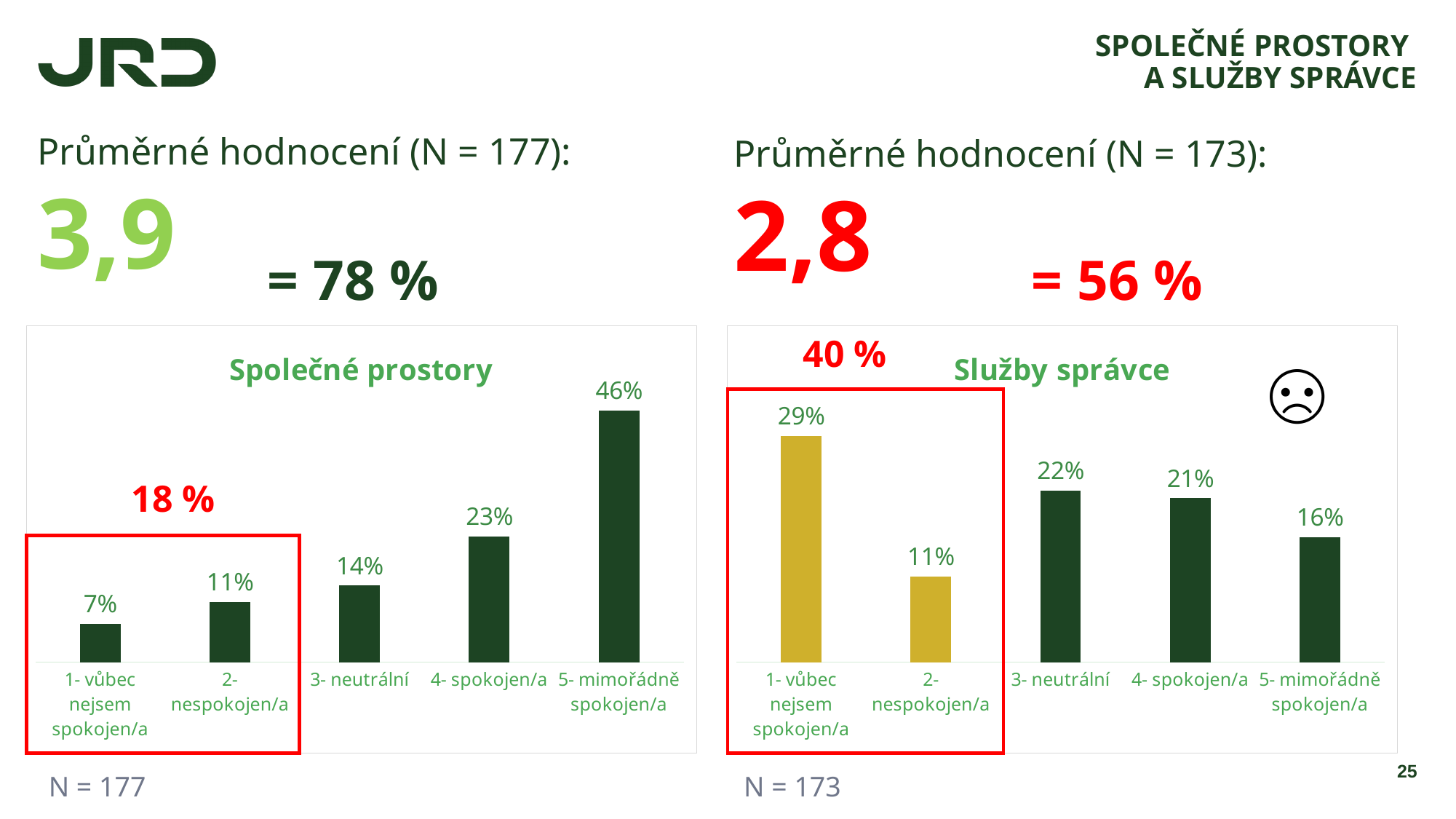
In the 'Služby správce' chart, what is the value for '4- spokojen/a'? 21% In the 'Společné prostory' chart, what is the value for '3- neutrální'? 14% In the 'Společné prostory' chart, which category has the highest value? 5- mimořádně spokojen/a In the 'Společné prostory' chart, what is the value for '5- mimořádně spokojen/a'? 46% In the 'Služby správce' chart, which category has the highest value? 1- vůbec nejsem spokojen/a In the 'Společné prostory' chart, what is the difference between '5- mimořádně spokojen/a' and '4- spokojen/a'? 23% In the 'Služby správce' chart, which category has the lowest value? 2- nespokojen/a In the 'Služby správce' chart, which is larger: '3- neutrální' or '5- mimořádně spokojen/a'? 3- neutrální How many categories does the 'Služby správce' chart show? 5 In the 'Služby správce' chart, what is the value for '1- vůbec nejsem spokojen/a'? 29% What type of chart is the 'Společné prostory' chart? bar chart In the 'Společné prostory' chart, which category has the lowest value? 1- vůbec nejsem spokojen/a